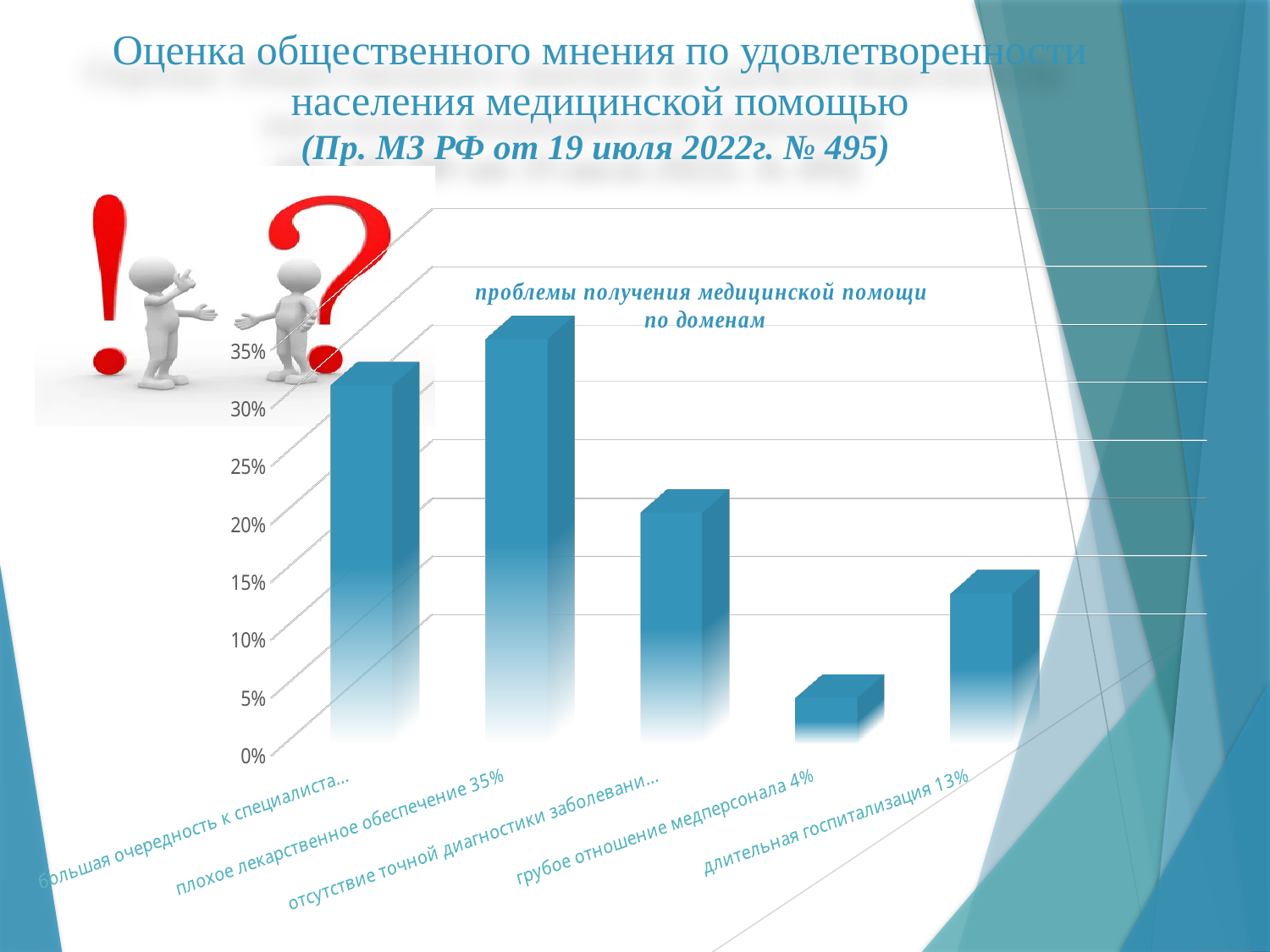
Which category has the highest value? плохое лекарственное обеспечение What is the value for грубое отношение медперсонала? 4% What is the difference between the values for плохое лекарственное обеспечение and грубое отношение медперсонала? 31 percentage points What is the value for плохое лекарственное обеспечение? 35% Which is larger: the value for длительная госпитализация or for грубое отношение медперсонала? длительная госпитализация What is the title of the chart? проблемы получения медицинской помощи по доменам Is the value for большая очередность к специалисту greater or less than 25%? greater How many categories (bars) does the chart show? 5 What is the value for длительная госпитализация? 13% Which category has the lowest value? грубое отношение медперсонала Is the value for отсутствие точной диагностики заболеваний greater or less than 25%? less What kind of chart is shown on the slide? bar chart